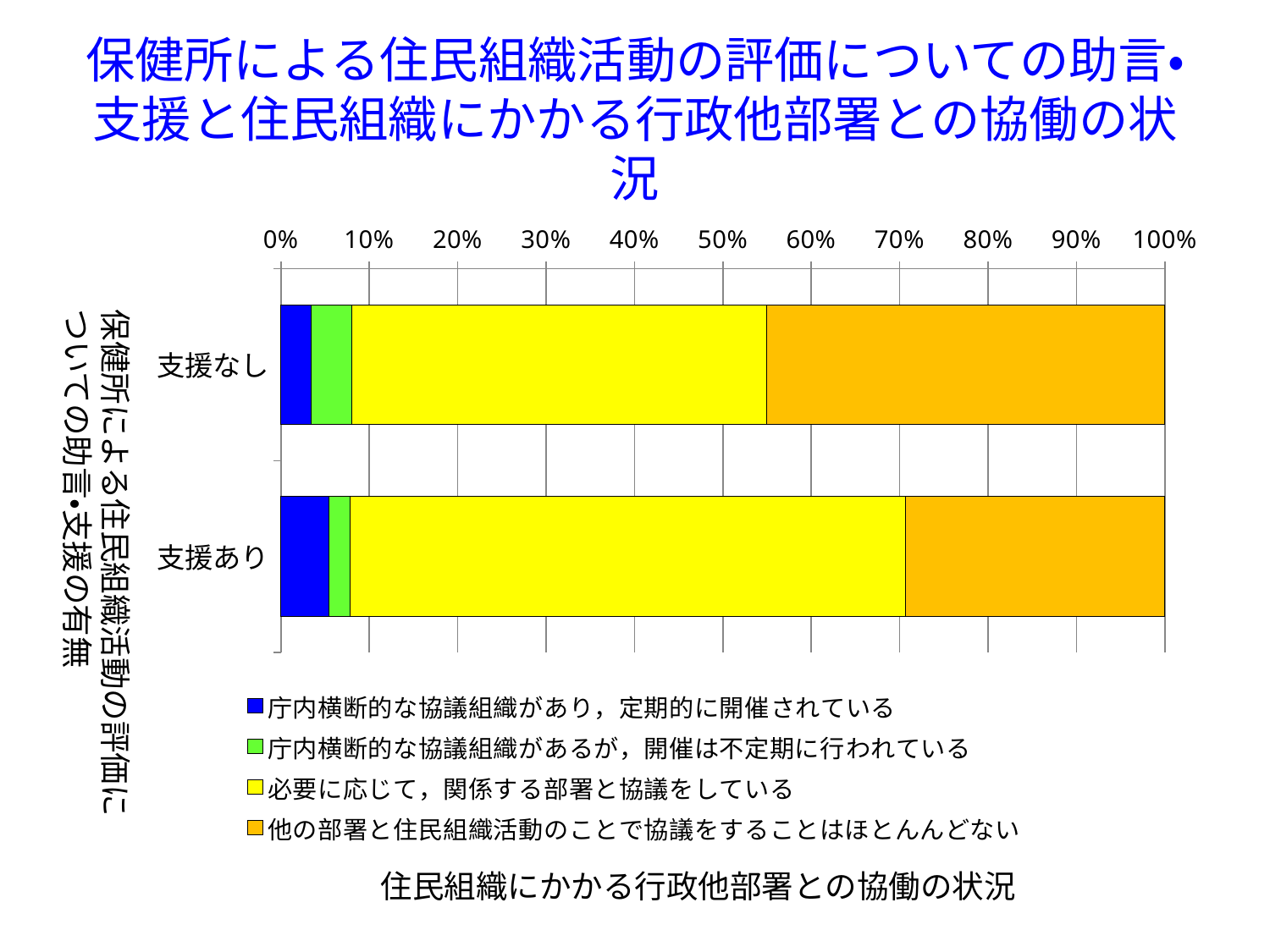
What kind of chart is shown on the slide? Stacked bar chart Is the share of the blue segment for 支援なし greater or less than 10%? less Which colour represents the series 必要に応じて，関係する部署と協議をしている in the legend? Yellow Which category has the larger blue segment (庁内横断的な協議組織があり，定期的に開催されている), 支援なし or 支援あり? 支援あり Which category has the larger orange segment (他の部署と住民組織活動のことで協議をすることはほとんんどない), 支援なし or 支援あり? 支援なし How many series does the chart's legend list? 4 How many categories are plotted on the vertical axis of the chart? 2 Is the share of the yellow segment for 支援あり greater or less than 50%? greater Which category has the larger green segment (庁内横断的な協議組織があるが，開催は不定期に行われている), 支援なし or 支援あり? 支援なし Is the share of the orange segment for 支援なし greater or less than 40%? greater What is the label of the horizontal axis shown below the legend? 住民組織にかかる行政他部署との協働の状況